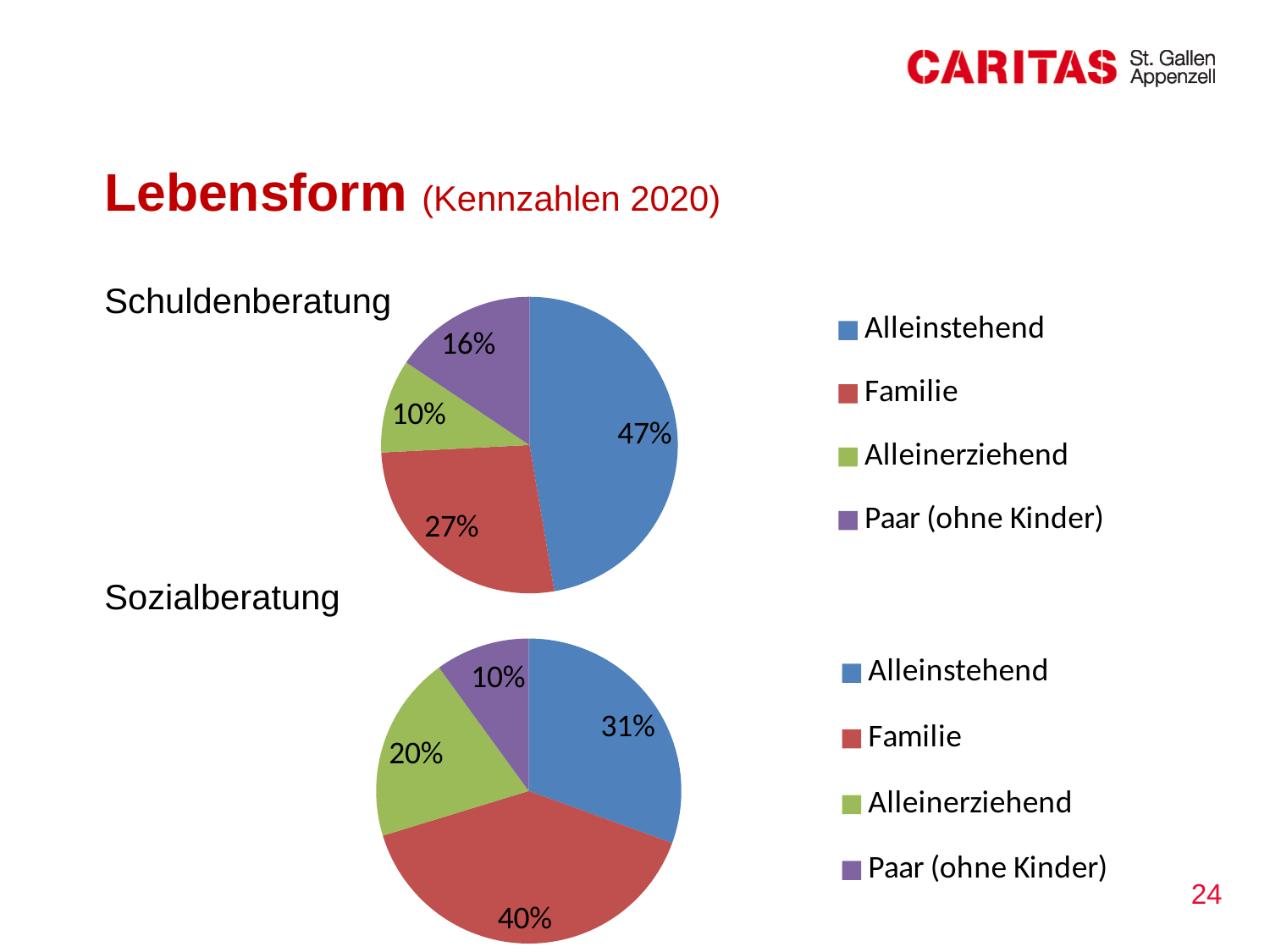
In the Schuldenberatung pie chart, what share is Familie? 27% In the Sozialberatung pie chart, which category has the smallest share? Paar (ohne Kinder) In the Schuldenberatung pie chart, which category has the smallest share? Alleinerziehend In the Schuldenberatung pie chart, which is larger: Paar (ohne Kinder) or Alleinerziehend? Paar (ohne Kinder) In the Sozialberatung pie chart, which colour represents Familie? Red In the Schuldenberatung pie chart, which category has the largest share? Alleinstehend In the Schuldenberatung pie chart, what share is Alleinstehend? 47% In the Sozialberatung pie chart, what share is Familie? 40% In the Sozialberatung pie chart, what is the difference between the Familie share and the Alleinstehend share? 9% How many categories does the legend of the Sozialberatung pie chart list? 4 In the Sozialberatung pie chart, what share is Alleinerziehend? 20% What kind of chart is used for Schuldenberatung? Pie chart